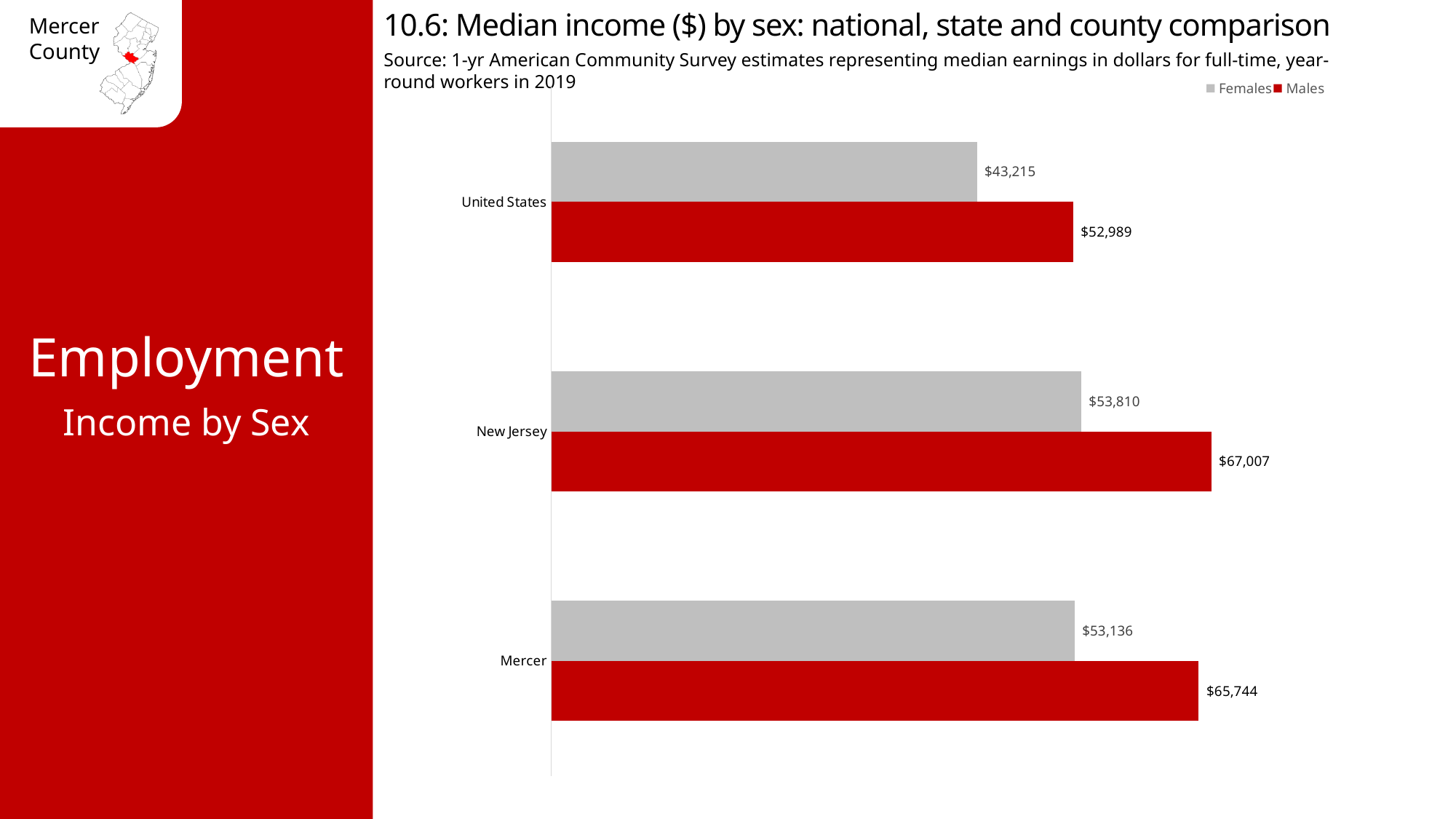
What is the median income for Males in Mercer? $65,744 Which category has the lowest median income for Females? United States How many categories are shown on the chart? 3 What is the median income for Females in the United States? $43,215 How many series does the legend list? 2 Which is larger: the Females median income in New Jersey or in Mercer? New Jersey What is the difference between the Males and Females median income in the United States? $9,774 What kind of chart is shown on the slide? Bar chart Which category has the highest median income for Males? New Jersey What is the median income for Females in Mercer? $53,136 What is the median income for Males in New Jersey? $67,007 What is the difference between the Males median income in New Jersey and in Mercer? $1,263